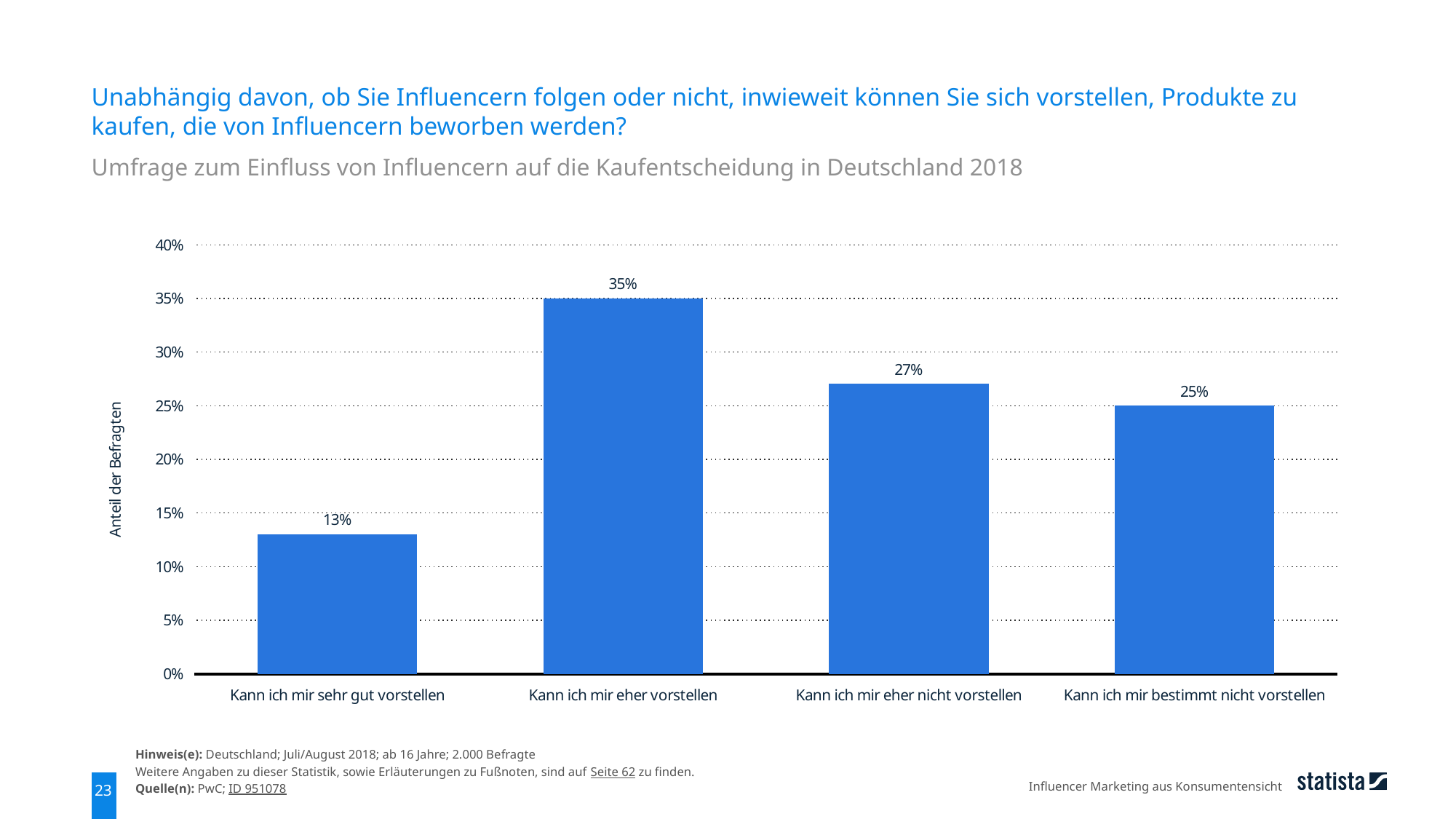
What kind of chart is shown on the slide? bar chart What is the value for "Kann ich mir sehr gut vorstellen"? 13% What is the value for "Kann ich mir eher vorstellen"? 35% Which category has the lowest value? Kann ich mir sehr gut vorstellen Is the value for "Kann ich mir sehr gut vorstellen" greater or less than 15%? less What is the value for "Kann ich mir eher nicht vorstellen"? 27% Which category has the highest value? Kann ich mir eher vorstellen How many categories are shown on the x axis? 4 Which is larger: "Kann ich mir eher nicht vorstellen" or "Kann ich mir bestimmt nicht vorstellen"? Kann ich mir eher nicht vorstellen What is the label of the y axis? Anteil der Befragten What is the value for "Kann ich mir bestimmt nicht vorstellen"? 25% What is the difference between "Kann ich mir eher vorstellen" and "Kann ich mir sehr gut vorstellen"? 22%